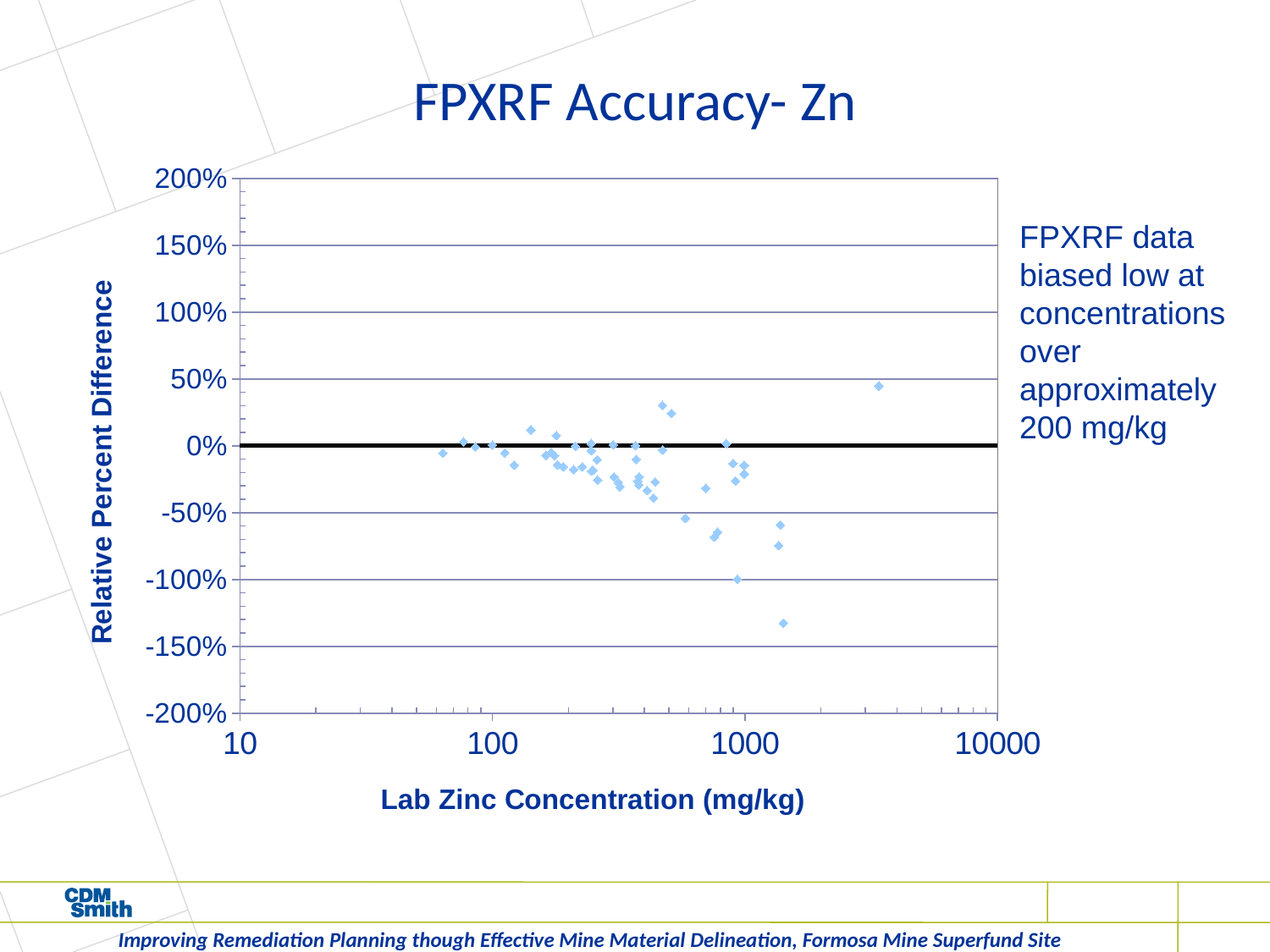
Is the highest plotted Relative Percent Difference value greater or less than 50%? less Is the highest plotted Relative Percent Difference value greater or less than 0%? greater What is the title of the x axis of the chart? Lab Zinc Concentration (mg/kg) Is the Lab Zinc Concentration of the highest plotted point greater or less than 1000 mg/kg? greater Are most of the plotted points above or below the 0% line? below What kind of chart is shown on the slide? scatter plot Do the Relative Percent Difference values generally rise or fall as Lab Zinc Concentration increases from 100 to 1000 mg/kg? fall What is the title of the chart? FPXRF Accuracy- Zn